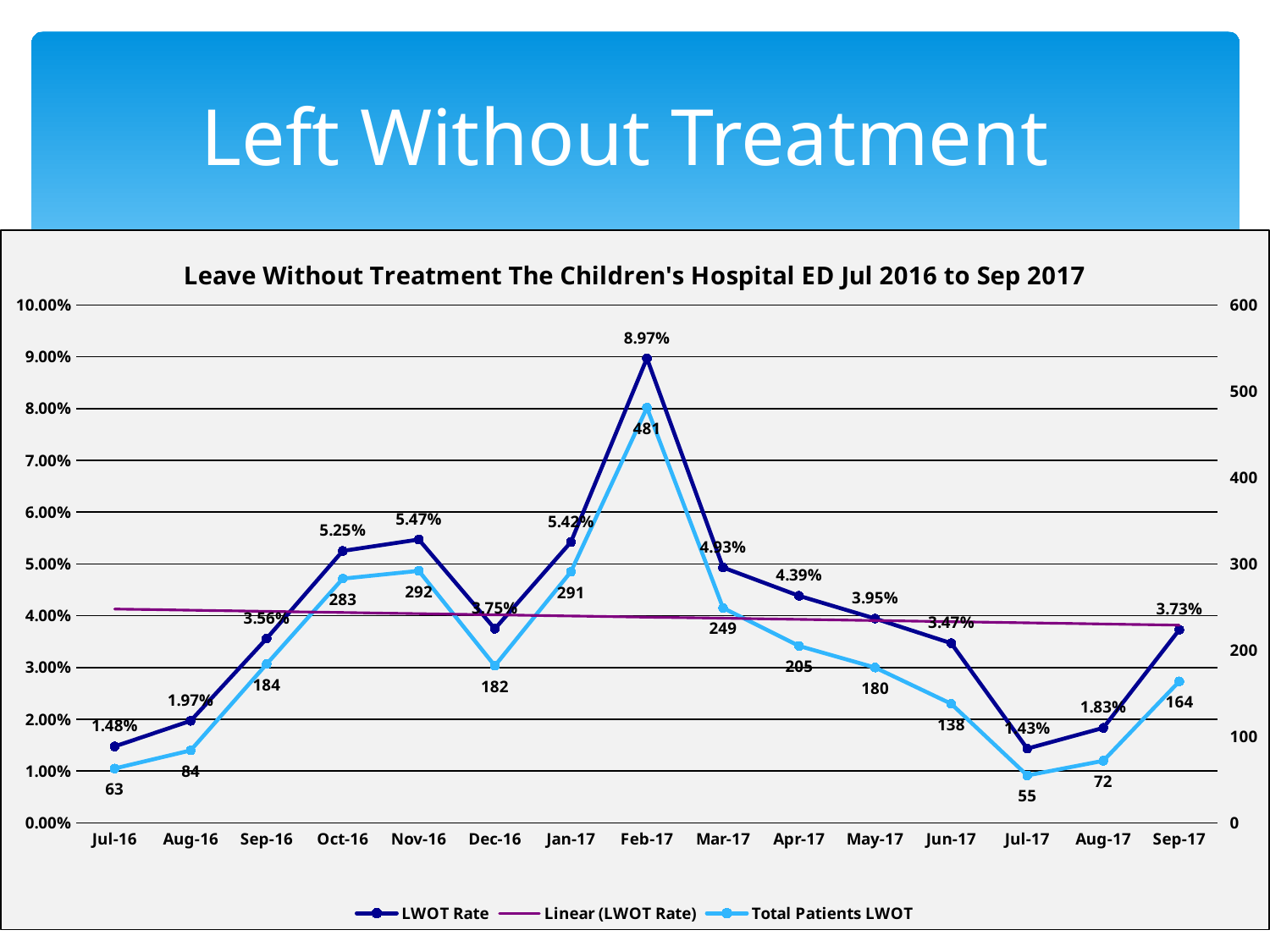
Which month has the highest LWOT Rate? Feb-17 What is the LWOT Rate for Feb-17? 8.97% Does the LWOT Rate rise or fall from Feb-17 to Jul-17? Fall Which month has a higher LWOT Rate, Oct-16 or Nov-16? Nov-16 What is the LWOT Rate for Jul-17? 1.43% What is the difference in Total Patients LWOT between Feb-17 and Mar-17? 232 How many series does the legend list? 3 How many months are plotted on the x axis? 15 What is the Total Patients LWOT value for Nov-16? 292 What is the title of the chart? Leave Without Treatment The Children's Hospital ED Jul 2016 to Sep 2017 What kind of chart is shown on the slide? Line chart Which month has the lowest Total Patients LWOT? Jul-17